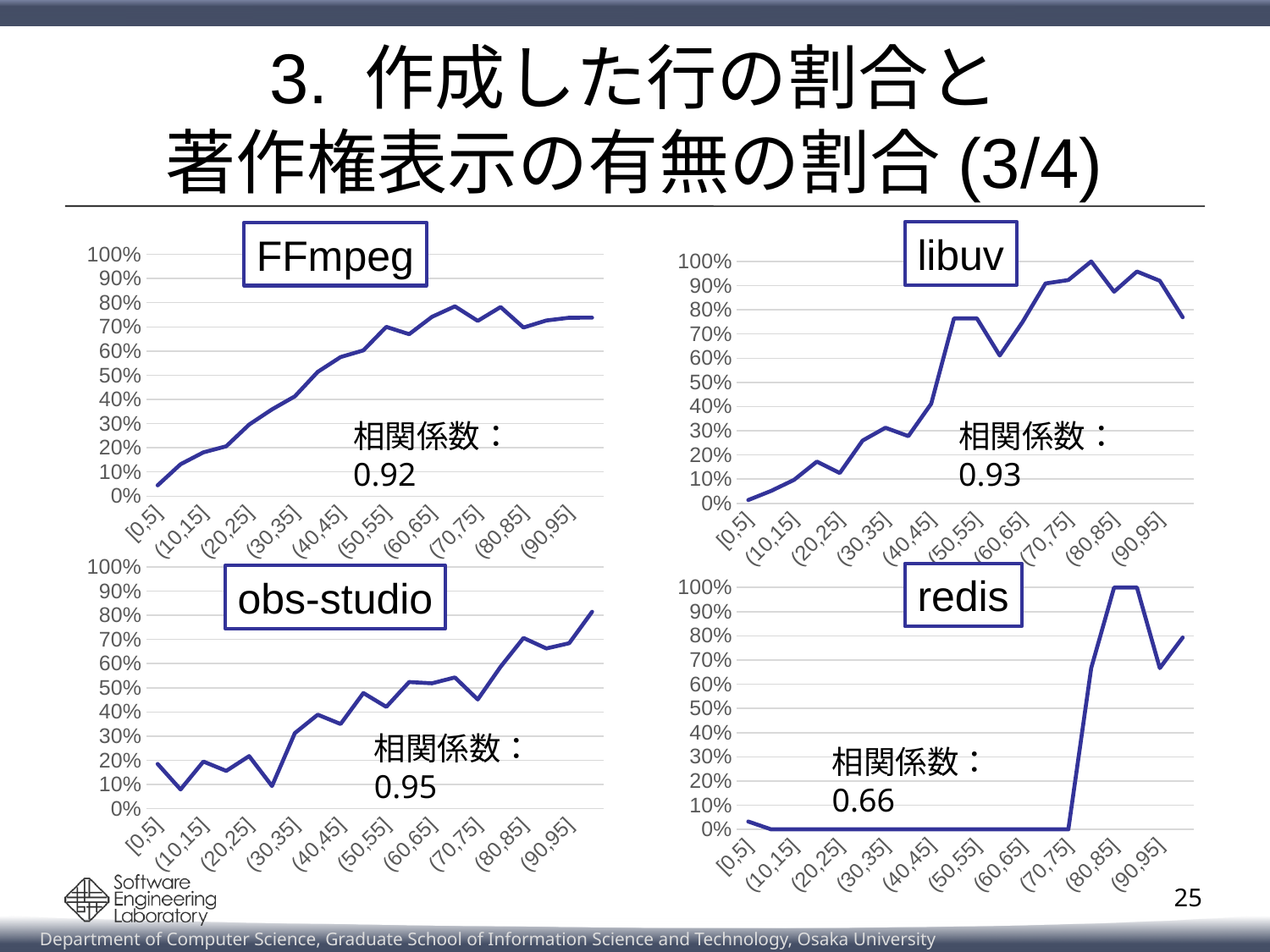
How many charts are shown on the slide? 4 In the obs-studio chart, what correlation coefficient (相関係数) is printed? 0.95 In the redis chart, what correlation coefficient (相関係数) is printed? 0.66 In the FFmpeg chart, what correlation coefficient (相関係数) is printed? 0.92 In the FFmpeg chart, is the value for [0,5] greater or less than 10%? less What kind of chart is the FFmpeg chart? line chart In the redis chart, what is the lowest value the line reaches? 0% In the FFmpeg chart, do the values generally rise or fall from left to right along the x axis? rise What are the titles of the four charts on the slide? FFmpeg, libuv, obs-studio, redis In the libuv chart, what is the highest value the line reaches? 100% In the libuv chart, what correlation coefficient (相関係数) is printed? 0.93